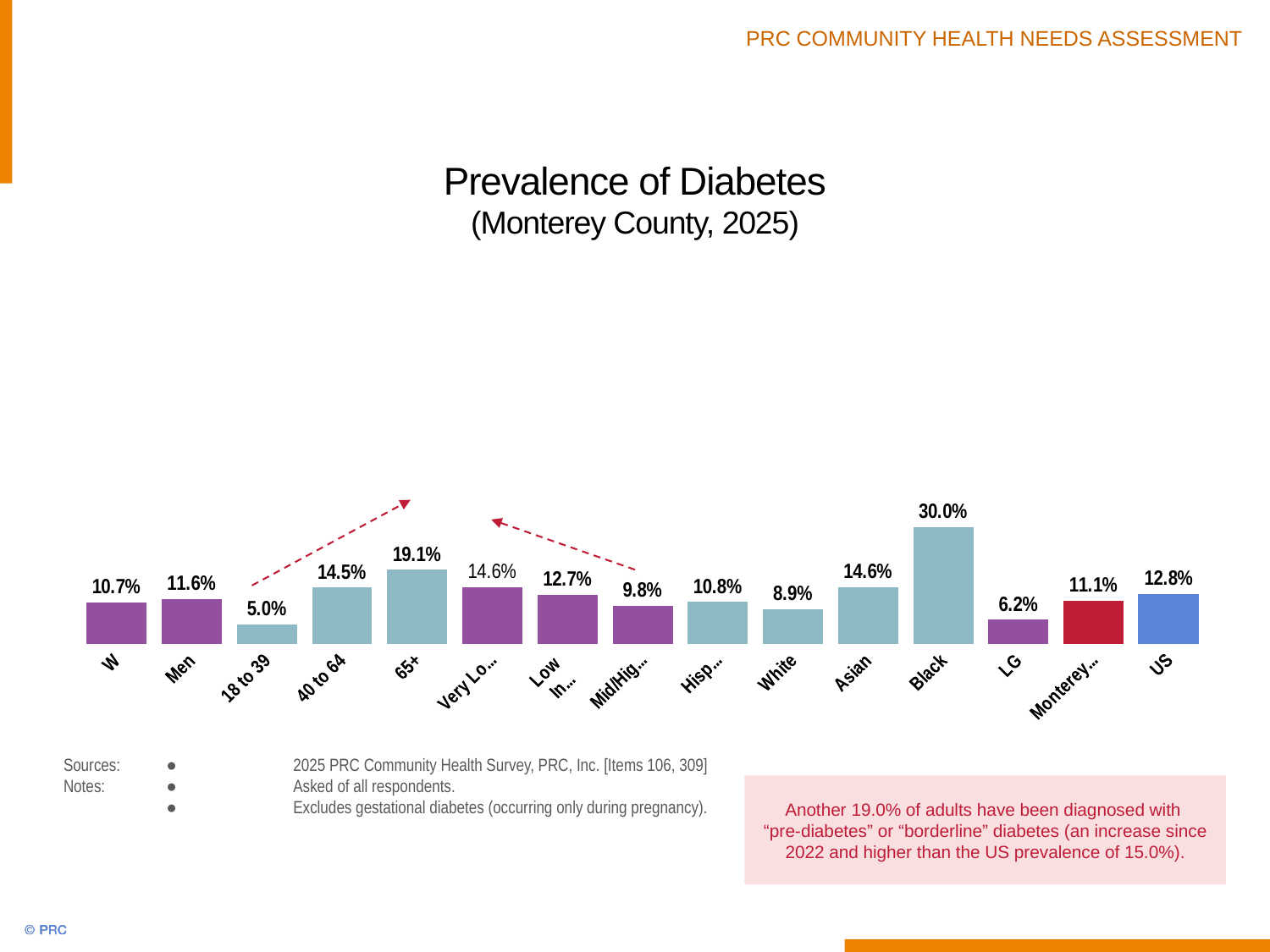
What is the prevalence of diabetes for Men? 11.6% What is the title of the chart? Prevalence of Diabetes (Monterey County, 2025) How many bars are plotted in the chart? 15 Which category has the lowest prevalence of diabetes? 18 to 39 What is the prevalence of diabetes for the 18 to 39 age group? 5.0% What is the US value shown in the chart? 12.8% What is the difference between the 65+ and 18 to 39 values? 14.1% Which is larger, the value for Asian or the value for White? Asian What is the prevalence of diabetes for Black respondents? 30.0% What type of chart is shown on the slide? bar chart Which category has the highest prevalence of diabetes? Black What is the prevalence of diabetes for the 65+ age group? 19.1%